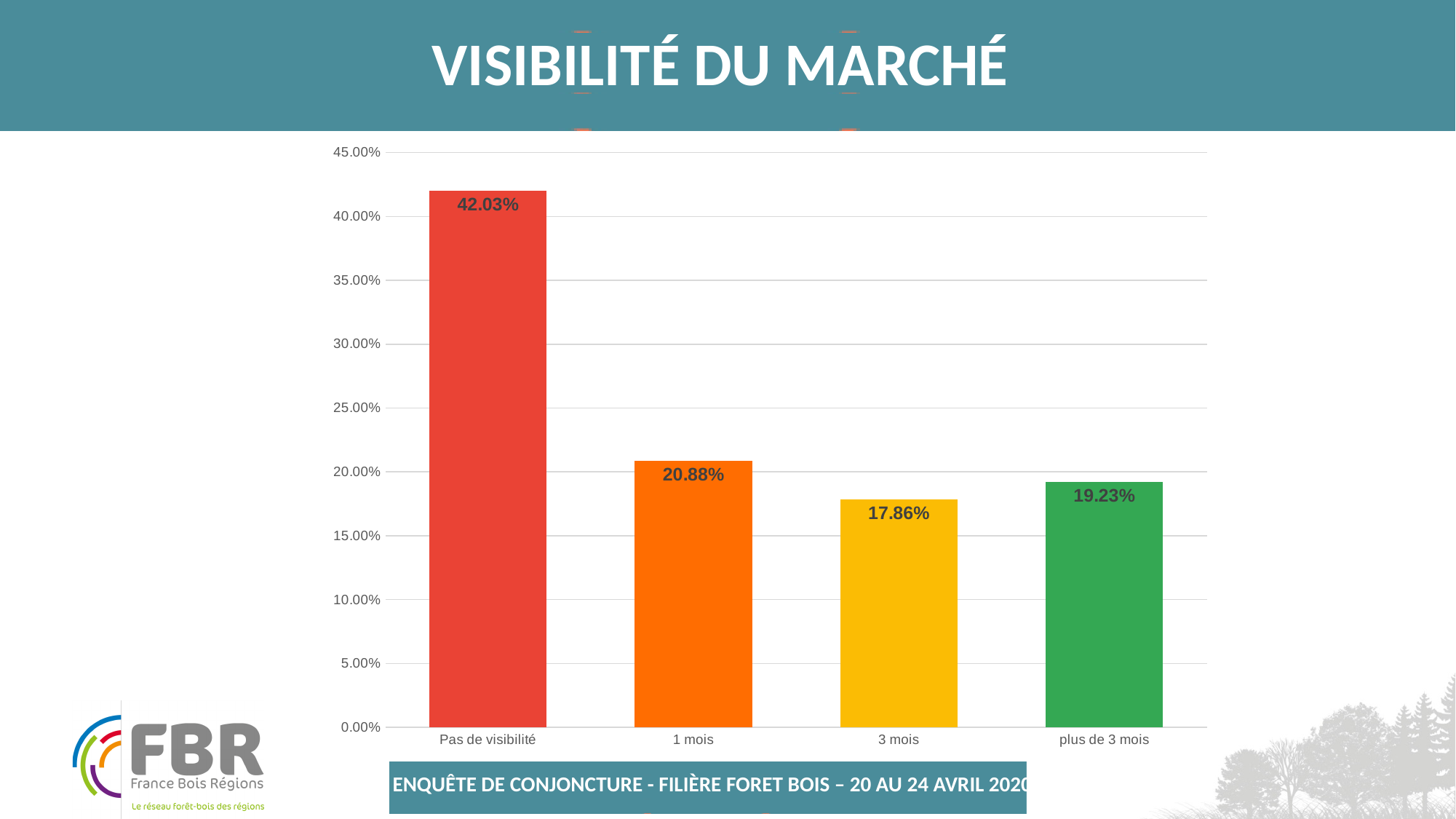
What is the value for "3 mois"? 17.86% Which is larger, the value for "1 mois" or the value for "plus de 3 mois"? 1 mois What kind of chart is shown on the slide? Bar chart What is the value for "1 mois"? 20.88% Is the value for "Pas de visibilité" greater or less than 40.00%? greater Which category has the highest value? Pas de visibilité How many categories are shown on the x axis? 4 Which category has the lowest value? 3 mois What is the value for "plus de 3 mois"? 19.23% What is the difference between the values for "Pas de visibilité" and "1 mois"? 21.15% What is the difference between the values for "plus de 3 mois" and "3 mois"? 1.37% What is the value for "Pas de visibilité"? 42.03%